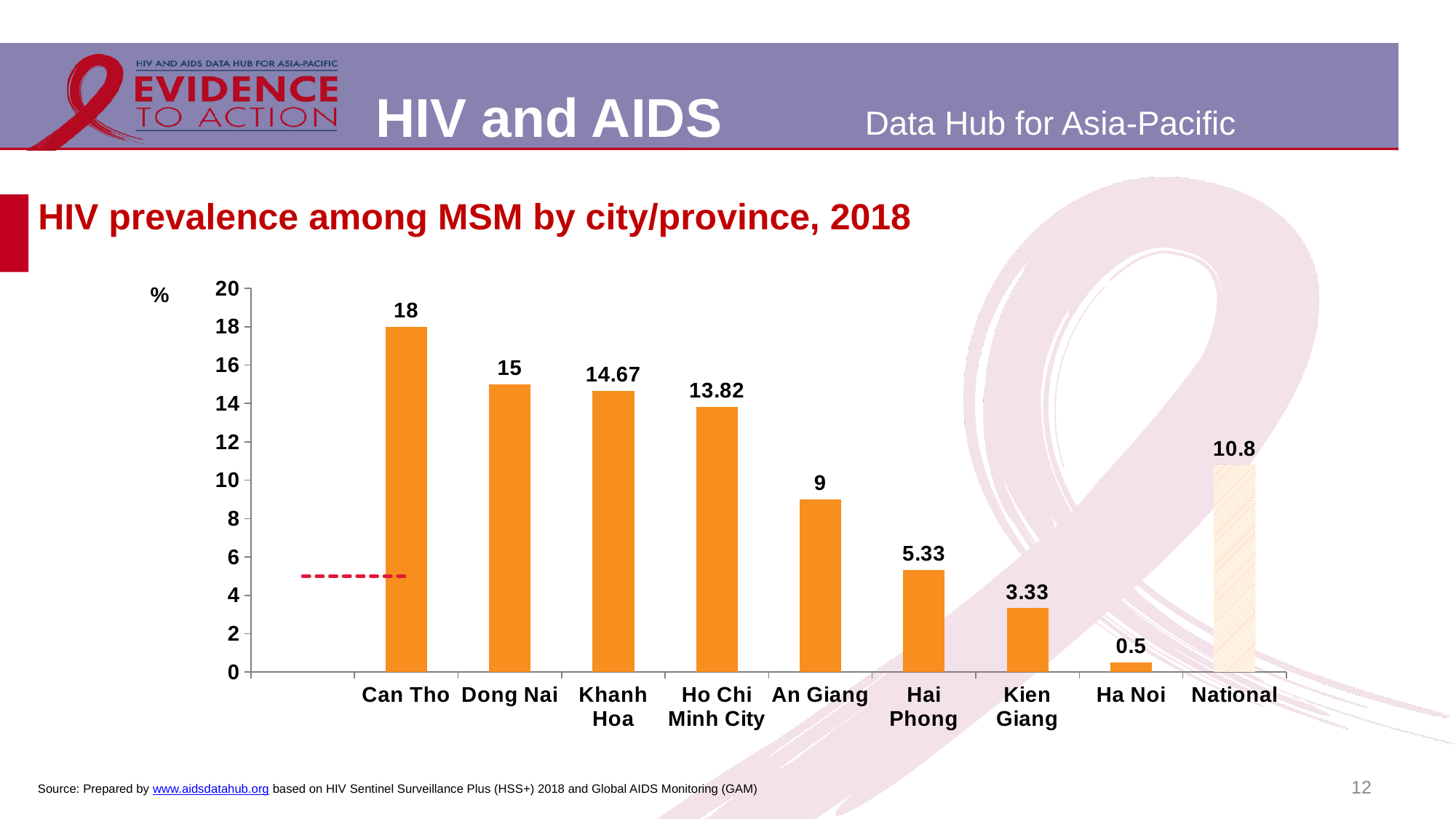
What is the National HIV prevalence among MSM shown on the chart? 10.8 Which city/province has the highest HIV prevalence among MSM? Can Tho How many cities/provinces (including National) are shown on the chart? 9 What is the difference between the HIV prevalence in Dong Nai and in An Giang? 6 Which city/province has the lowest HIV prevalence among MSM? Ha Noi What is the HIV prevalence among MSM in Khanh Hoa? 14.67 What is the difference between the HIV prevalence in Hai Phong and in Kien Giang? 2 What is the HIV prevalence among MSM in Can Tho? 18 What kind of chart is shown on the slide? Bar chart Which has a higher HIV prevalence among MSM, Ho Chi Minh City or An Giang? Ho Chi Minh City What is the title of the chart? HIV prevalence among MSM by city/province, 2018 What is the HIV prevalence among MSM in Ho Chi Minh City? 13.82